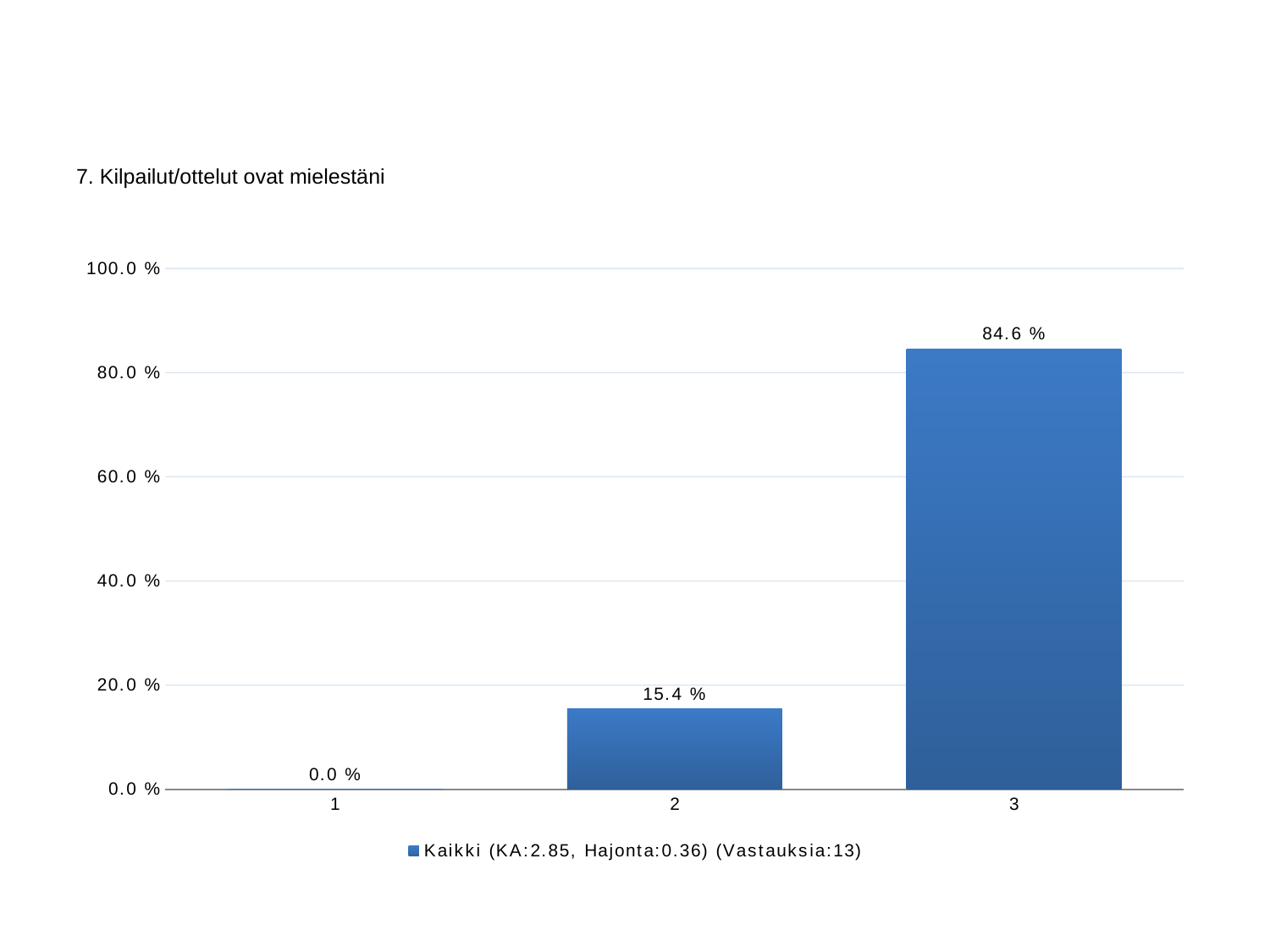
How many series does the legend list? 1 Is the value for category 3 greater or less than 80.0 %? greater What is the value for category 2? 15.4 % Which category has the highest value? 3 What kind of chart is shown? bar chart Which category has the lowest value? 1 Which is larger, the value for category 2 or category 3? 3 What is the difference between the values for category 3 and category 2? 69.2 % What is the value for category 1? 0.0 % What is the value for category 3? 84.6 % Do the values rise or fall from category 1 to category 3? rise How many categories are shown on the x axis? 3